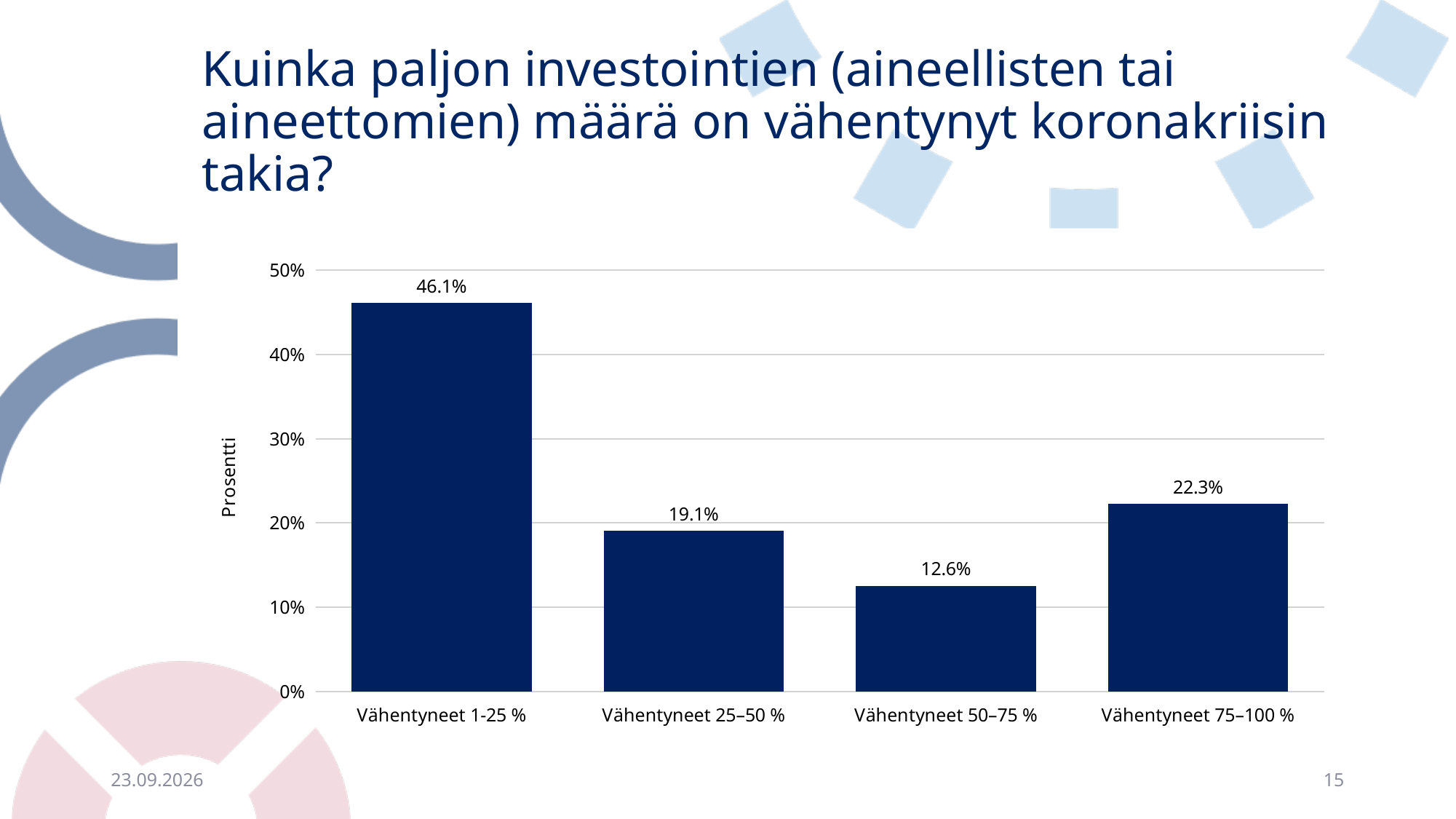
Which is larger, the value for Vähentyneet 25–50 % or the value for Vähentyneet 75–100 %? Vähentyneet 75–100 % What is the value for Vähentyneet 50–75 %? 12.6% Which category has the lowest value? Vähentyneet 50–75 % What is the value for Vähentyneet 25–50 %? 19.1% How many categories are shown on the x axis? 4 Which category has the highest value? Vähentyneet 1-25 % What is the value for Vähentyneet 75–100 %? 22.3% What is the label of the vertical axis? Prosentti What is the difference between the values for Vähentyneet 1-25 % and Vähentyneet 75–100 %? 23.8% What is the value for Vähentyneet 1-25 %? 46.1% Is the value for Vähentyneet 50–75 % greater or less than 20%? less What kind of chart is shown on the slide? bar chart